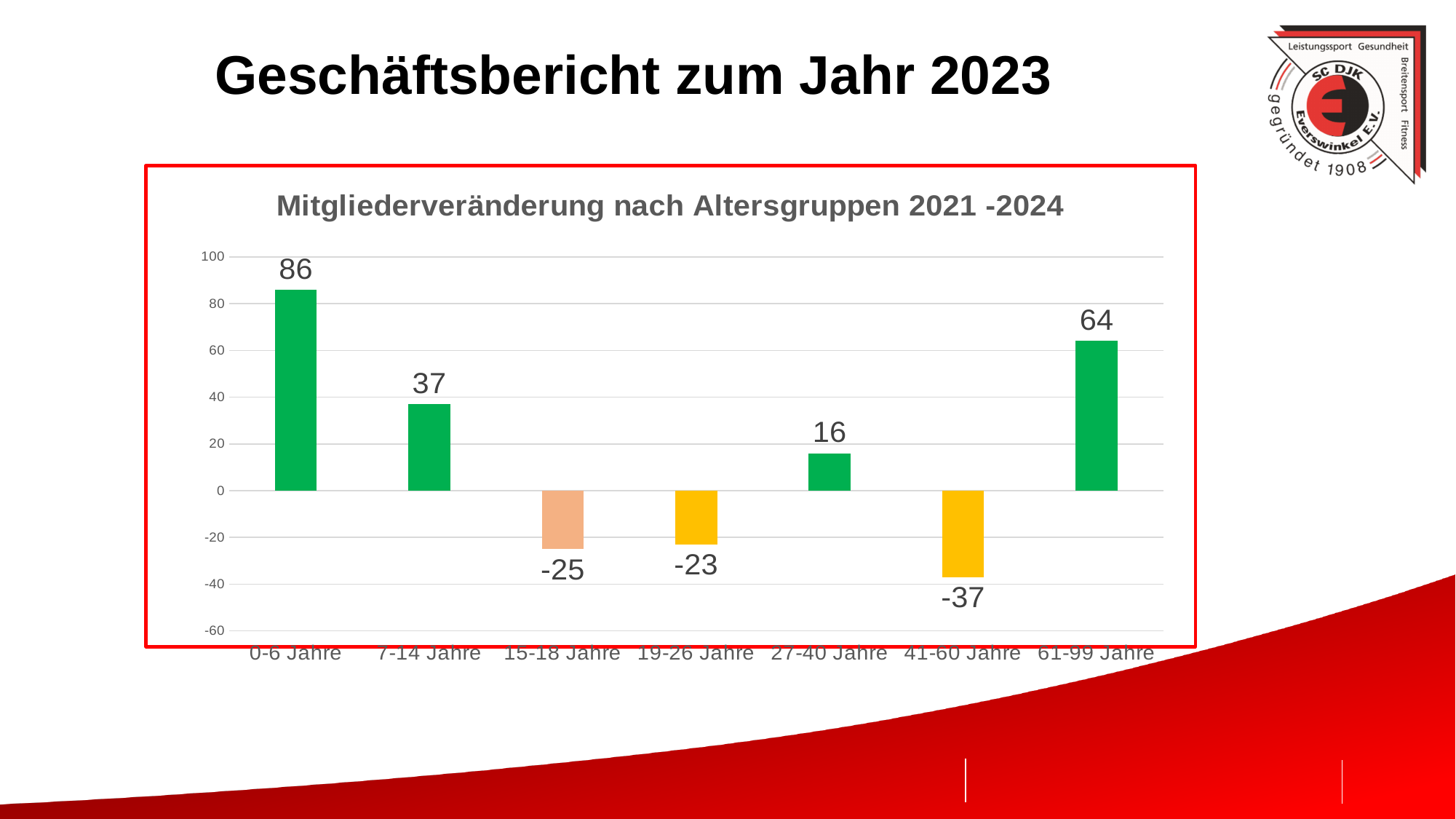
Which age group has the highest value? 0-6 Jahre Which age group has the lowest value? 41-60 Jahre What is the value for 41-60 Jahre? -37 What is the difference between the values for 0-6 Jahre and 61-99 Jahre? 22 Which is larger, the value for 7-14 Jahre or the value for 61-99 Jahre? 61-99 Jahre What kind of chart is shown on the slide? bar chart How many age groups are shown in the chart? 7 What is the value for 0-6 Jahre? 86 What is the title of the chart? Mitgliederveränderung nach Altersgruppen 2021 -2024 What is the value for 19-26 Jahre? -23 What is the value for 27-40 Jahre? 16 Is the value for 15-18 Jahre greater or less than 0? less